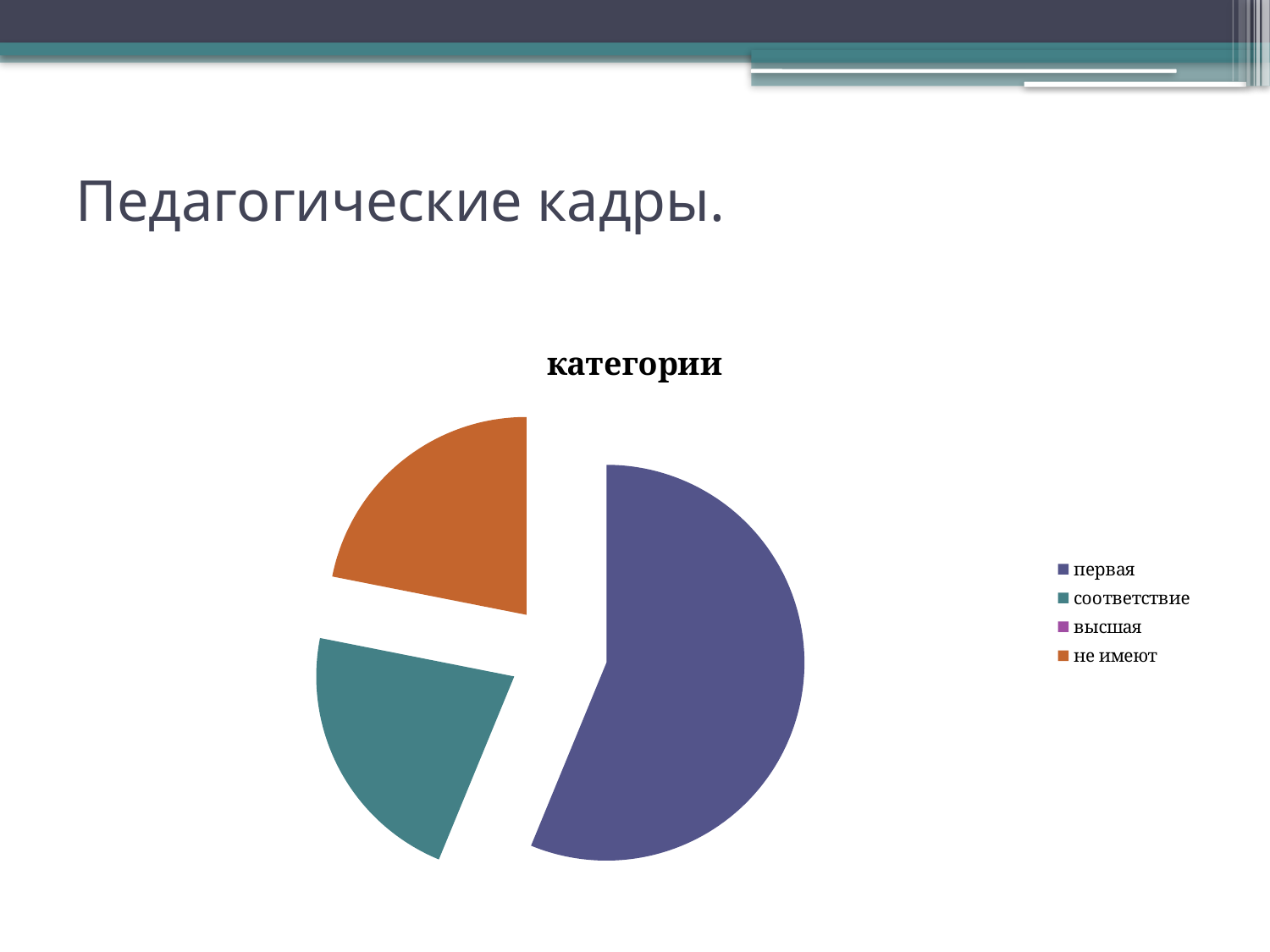
Which slice is larger, первая or не имеют? первая Which colour represents the category не имеют in the chart? orange Which slice is larger, первая or соответствие? первая How many categories does the chart's legend list? 4 What kind of chart is shown on the slide? pie chart Which category has the largest slice of the pie? первая What is the title of the chart? категории Does the slice for первая take up more or less than half of the pie? more